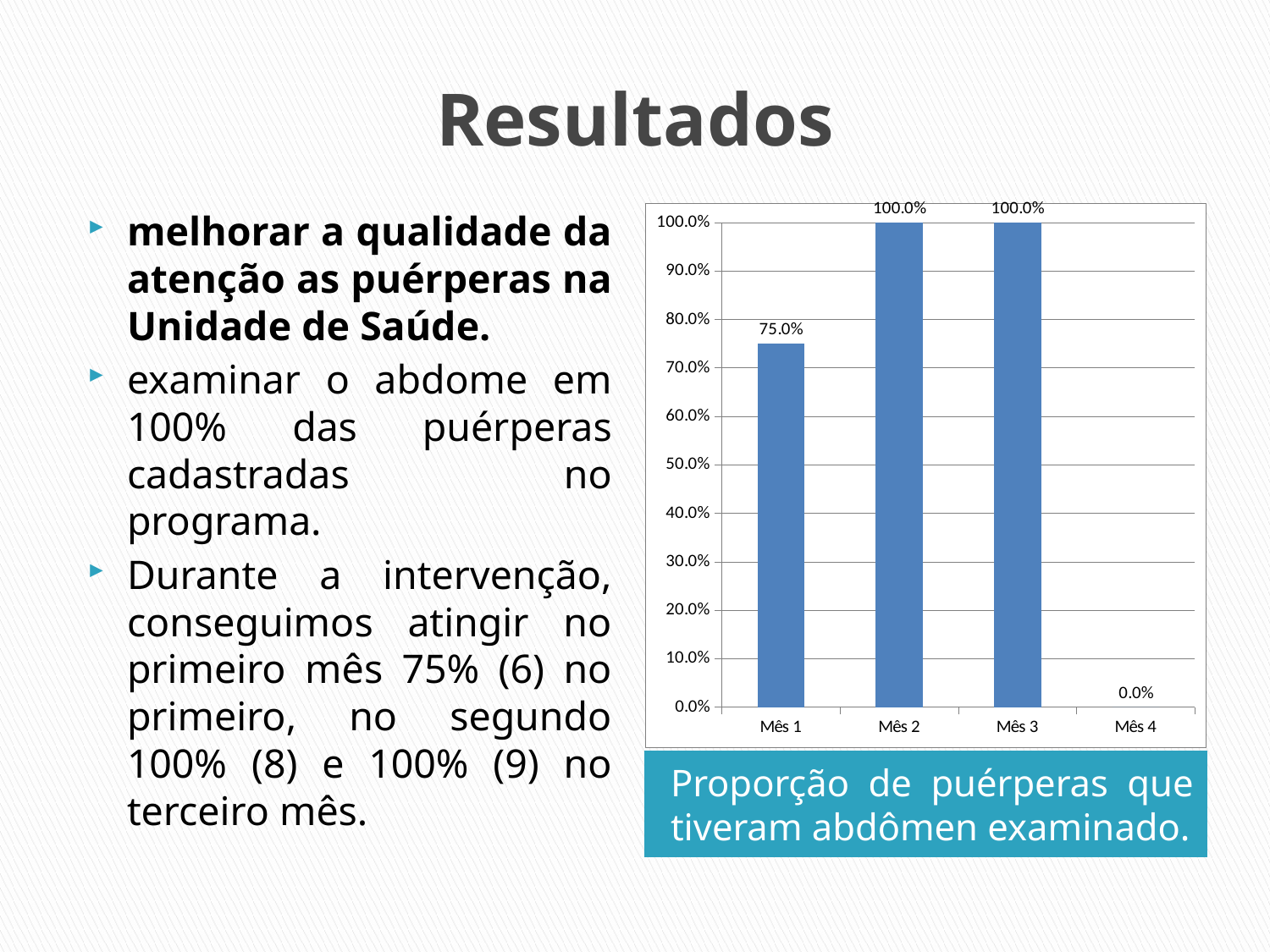
Which month has the lowest value? Mês 4 What is the caption below the chart? Proporção de puérperas que tiveram abdômen examinado. What is the difference between the values for Mês 2 and Mês 1? 25.0% What is the value for Mês 1? 75.0% What is the value for Mês 4? 0.0% What is the value for Mês 2? 100.0% What colour are the bars in the chart? blue Do the values rise or fall from Mês 1 to Mês 2? rise How many months are shown on the x axis? 4 What kind of chart is shown? bar chart Is the value for Mês 1 greater or less than 70.0%? greater Which is larger, the value for Mês 1 or the value for Mês 3? Mês 3